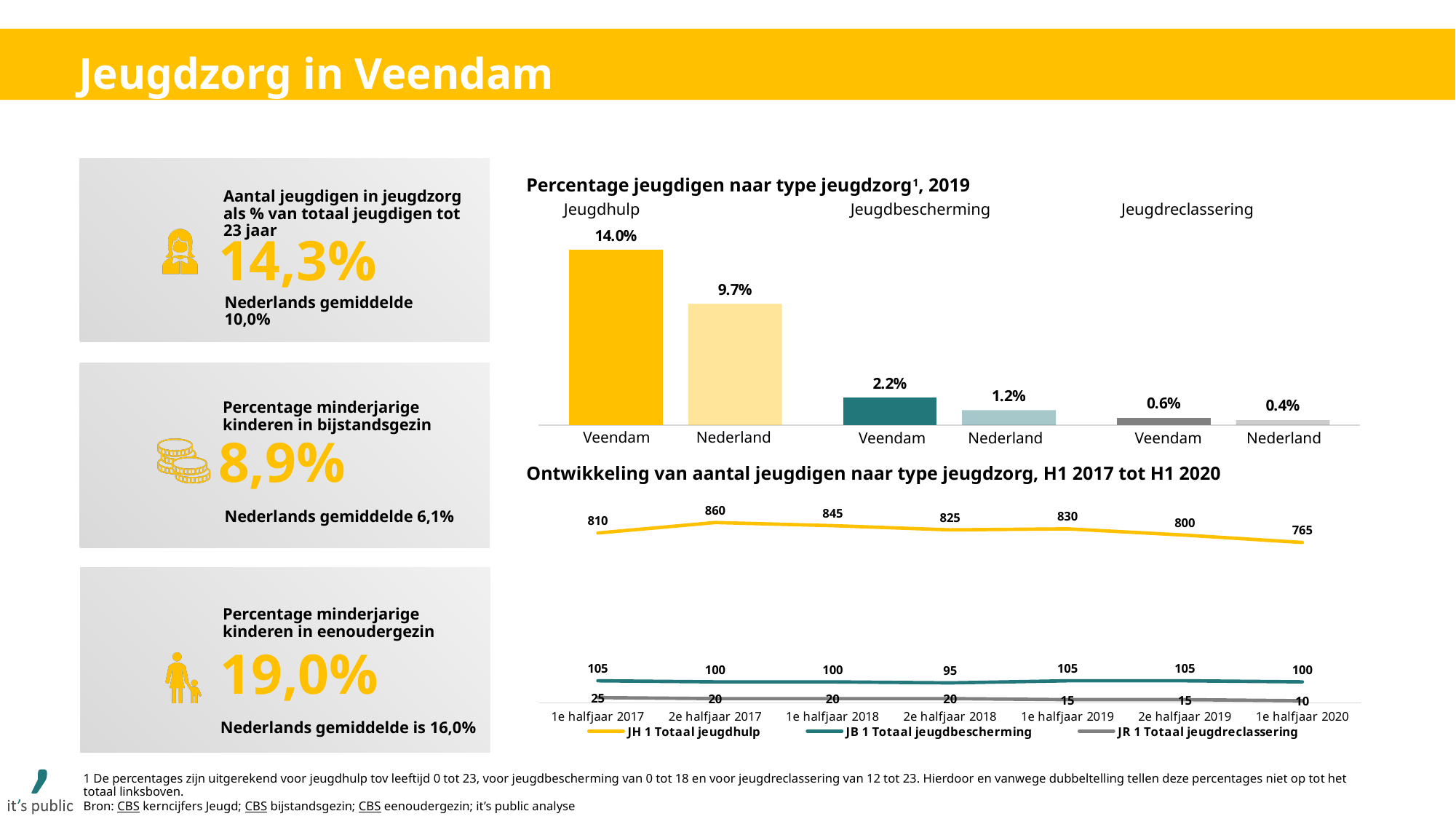
In the chart 'Percentage jeugdigen naar type jeugdzorg, 2019', how many bars are plotted? 6 In the chart 'Ontwikkeling van aantal jeugdigen naar type jeugdzorg, H1 2017 tot H1 2020', what is the difference between the JH 1 Totaal jeugdhulp values in 1e halfjaar 2017 and 1e halfjaar 2020? 45 In the chart 'Percentage jeugdigen naar type jeugdzorg, 2019', what is the Jeugdbescherming value for Nederland? 1.2% In the chart 'Percentage jeugdigen naar type jeugdzorg, 2019', what is the difference between the Jeugdhulp values for Veendam and Nederland? 4.3% In the chart 'Ontwikkeling van aantal jeugdigen naar type jeugdzorg, H1 2017 tot H1 2020', what is the value of JH 1 Totaal jeugdhulp in 2e halfjaar 2017? 860 In the chart 'Ontwikkeling van aantal jeugdigen naar type jeugdzorg, H1 2017 tot H1 2020', how many series does the legend list? 3 In the chart 'Ontwikkeling van aantal jeugdigen naar type jeugdzorg, H1 2017 tot H1 2020', does the JR 1 Totaal jeugdreclassering series rise or fall from 1e halfjaar 2017 to 1e halfjaar 2020? Fall In the chart 'Percentage jeugdigen naar type jeugdzorg, 2019', which bar is the highest? Jeugdhulp Veendam What kind of chart is 'Percentage jeugdigen naar type jeugdzorg, 2019'? Bar chart In the chart 'Ontwikkeling van aantal jeugdigen naar type jeugdzorg, H1 2017 tot H1 2020', what is the value of JR 1 Totaal jeugdreclassering in 1e halfjaar 2020? 10 In the chart 'Percentage jeugdigen naar type jeugdzorg, 2019', which bar is the lowest? Jeugdreclassering Nederland In the chart 'Percentage jeugdigen naar type jeugdzorg, 2019', what is the Jeugdhulp value for Veendam? 14.0%